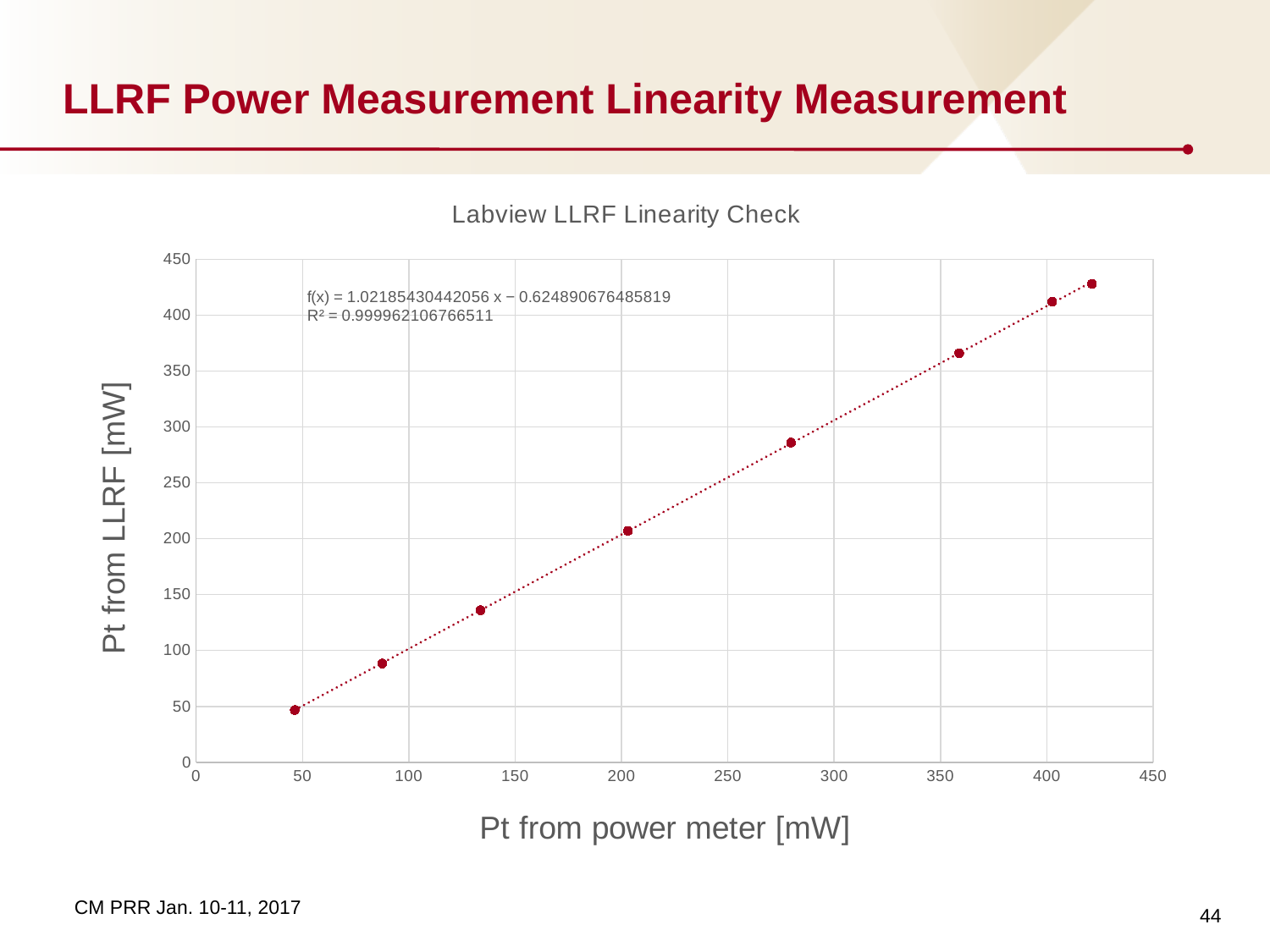
How many data points are plotted in the chart? 8 What is the label of the x axis of the chart? Pt from power meter [mW] What type of chart is shown on the slide? scatter chart What R² value is printed on the chart for the fitted line? 0.999962106766511 Is the Pt from LLRF value of the highest plotted point greater or less than 400? greater Which plotted point has the highest Pt from LLRF value: the one near 420 mW or the one near 50 mW on the x axis? the one near 420 mW Is the Pt from LLRF value of the lowest plotted point greater or less than 100? less What is the title of the chart? Labview LLRF Linearity Check What is the fitted line equation printed on the chart? f(x) = 1.02185430442056 x − 0.624890676485819 Do the plotted values rise or fall as the power meter reading increases along the x axis? rise Is the Pt from LLRF value of the point near 200 mW on the x axis greater or less than 150? greater